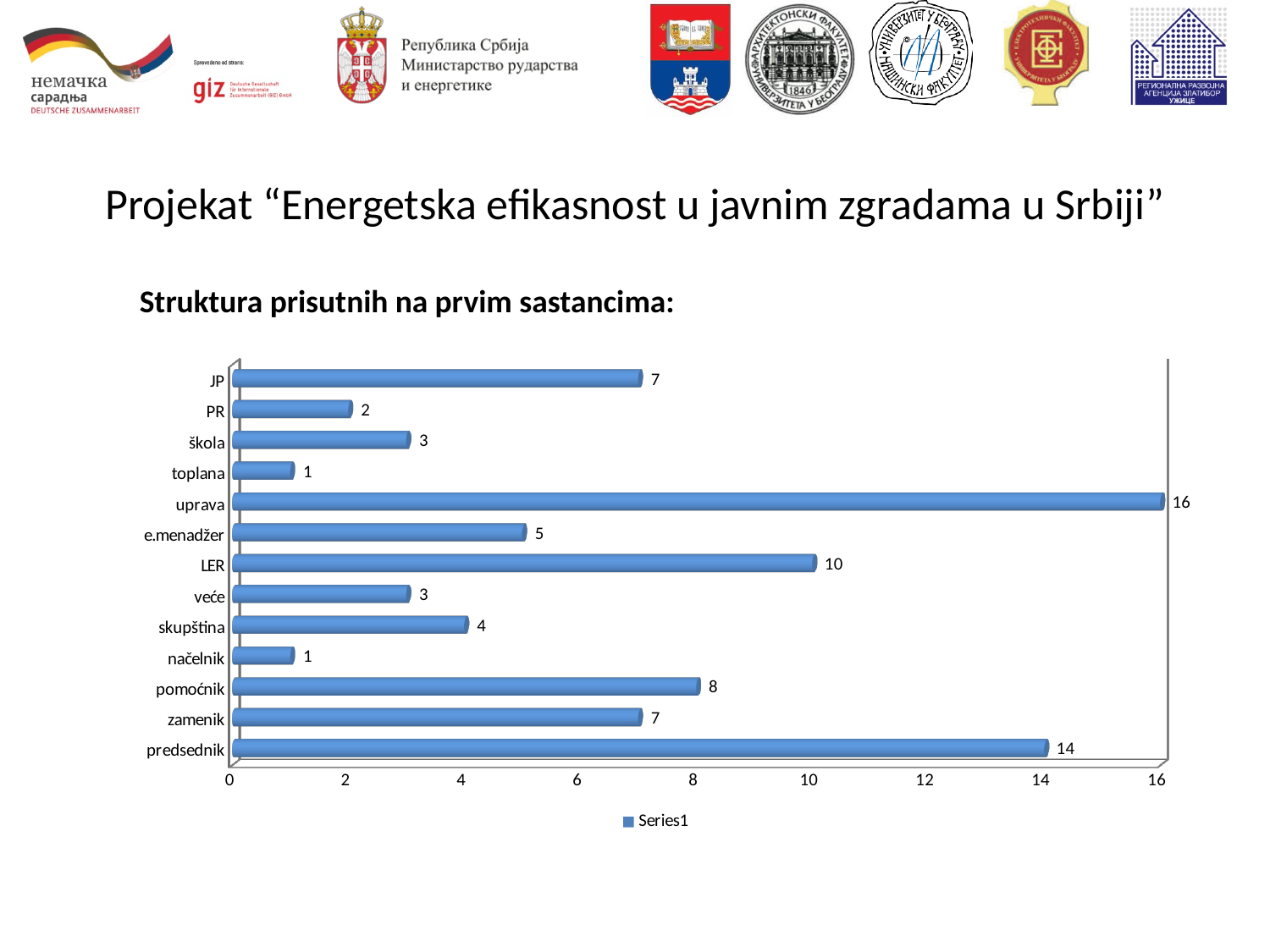
Which is larger, the value for pomoćnik or the value for zamenik? pomoćnik What is the value for e.menadžer? 5 What is the difference between the values for LER and skupština? 6 What is the name of the series listed in the legend? Series1 Which category has the highest value? uprava What kind of chart is shown on the slide? bar chart What is the value for uprava? 16 What is the difference between the values for uprava and predsednik? 2 How many series does the legend list? 1 What is the value for predsednik? 14 What is the value for LER? 10 How many categories are shown in the chart? 13